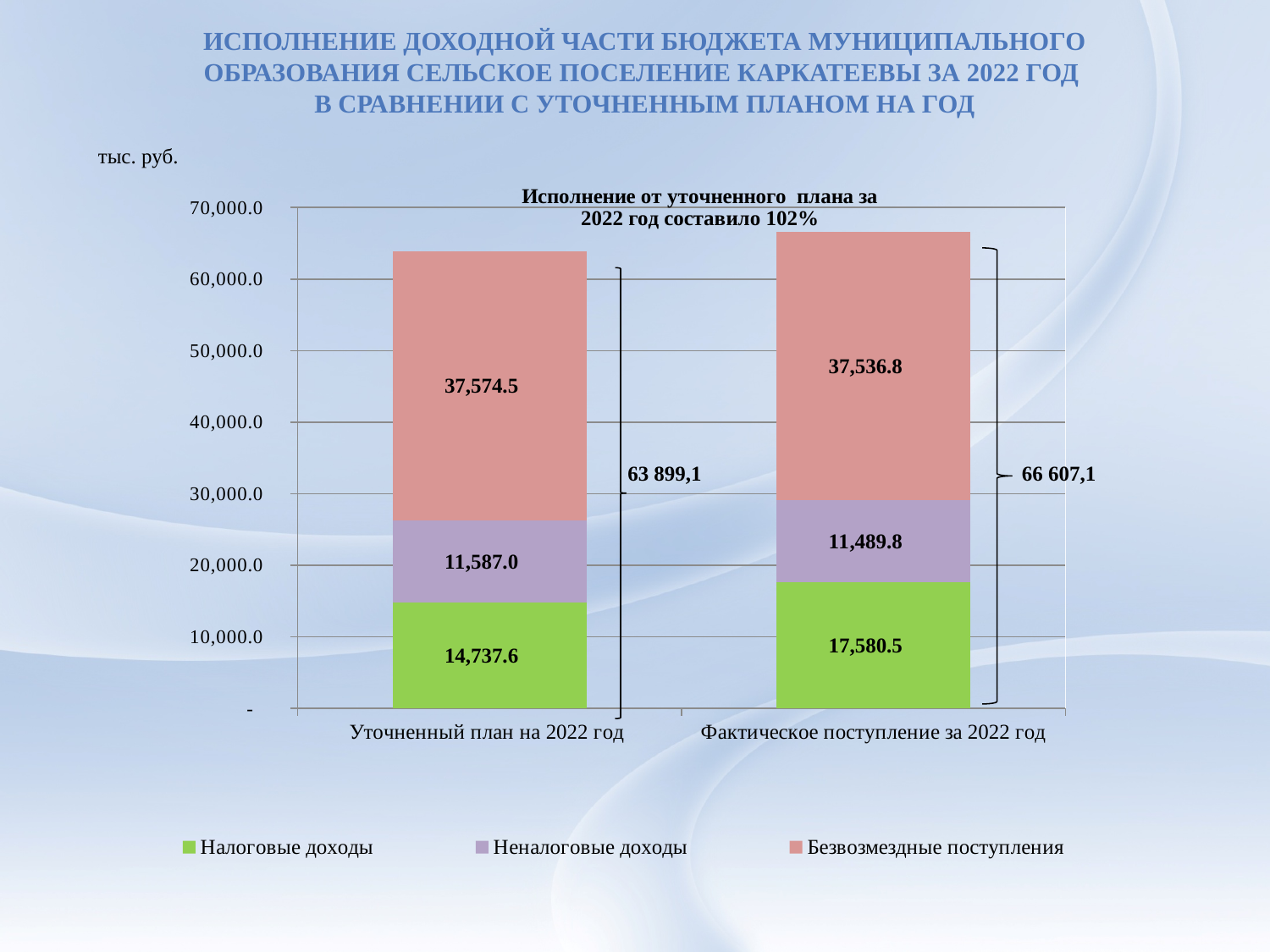
What is the difference between Налоговые доходы for Фактическое поступление за 2022 год and for Уточненный план на 2022 год? 2,842.9 What is the value of Неналоговые доходы for Фактическое поступление за 2022 год? 11,489.8 What is the value of Налоговые доходы for Фактическое поступление за 2022 год? 17,580.5 What is the total of the stacked bar for Уточненный план на 2022 год? 63 899,1 What type of chart is shown on the slide? stacked bar chart What percentage of the refined plan was executed in 2022, according to the text on the chart? 102% Which is larger: Неналоговые доходы for Уточненный план на 2022 год or for Фактическое поступление за 2022 год? Уточненный план на 2022 год How many categories are shown on the x axis? 2 What is the value of Налоговые доходы for Уточненный план на 2022 год? 14,737.6 How many series does the legend list? 3 What is the value of Безвозмездные поступления for Уточненный план на 2022 год? 37,574.5 What is the total of the stacked bar for Фактическое поступление за 2022 год? 66 607,1